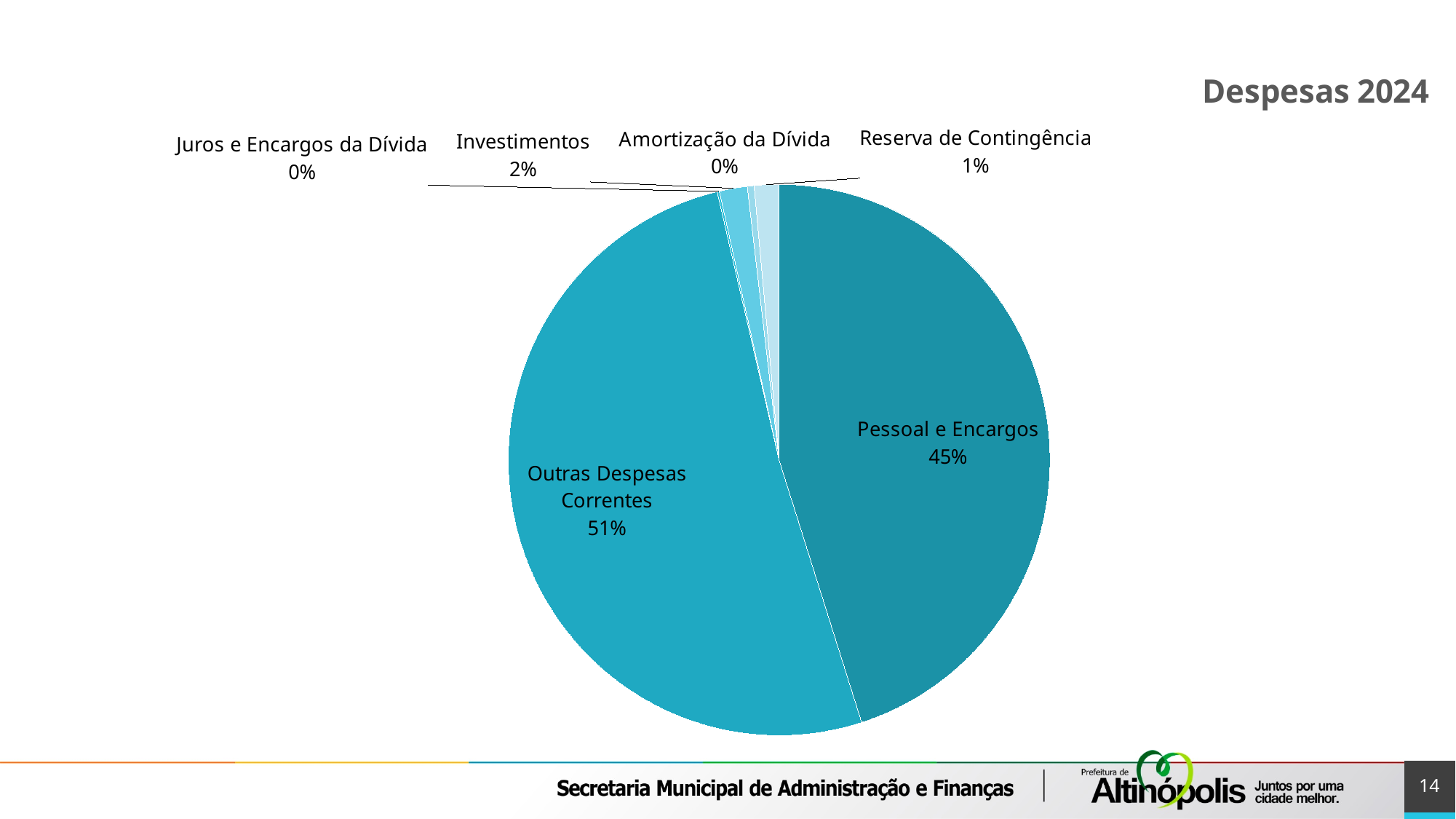
What share of the pie does Pessoal e Encargos represent? 45% What percentage is shown for Reserva de Contingência? 1% Which is larger, Investimentos or Reserva de Contingência? Investimentos What is the difference in percentage points between Outras Despesas Correntes and Pessoal e Encargos? 6 Which category has the largest slice of the pie? Outras Despesas Correntes What type of chart is shown on the slide? pie chart What percentage is shown for Investimentos? 2% What is the title of the chart? Despesas 2024 How many categories are shown in the pie chart? 6 What share of the pie does Outras Despesas Correntes represent? 51% What is the combined share of Outras Despesas Correntes and Pessoal e Encargos? 96% What percentage is shown for Juros e Encargos da Dívida? 0%